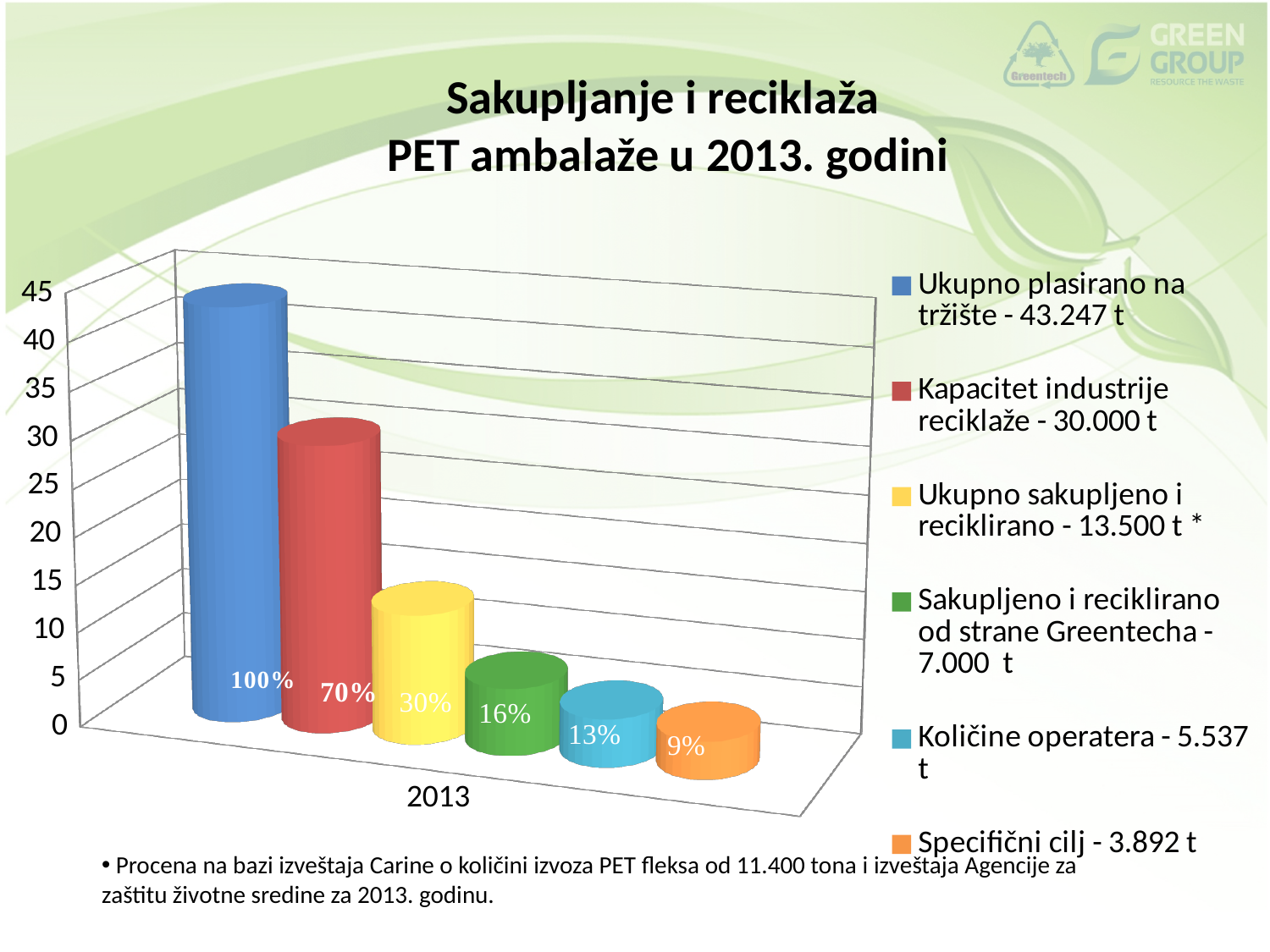
Which is larger, the bar for "Količine operatera" or the bar for "Specifični cilj"? Količine operatera Which series has the highest bar? Ukupno plasirano na tržište What is the data label on the bar for "Kapacitet industrije reciklaže"? 70% How many series does the legend list? 6 How many categories are shown on the x axis? 1 What is the data label on the bar for "Ukupno sakupljeno i reciklirano"? 30% What is the data label on the bar for "Količine operatera"? 13% What is the data label on the bar for "Ukupno plasirano na tržište"? 100% What is the data label on the bar for "Sakupljeno i reciklirano od strane Greentecha"? 16% What kind of chart is shown on the slide? bar chart Which series has the lowest bar? Specifični cilj What is the title of the slide? Sakupljanje i reciklaža PET ambalaže u 2013. godini